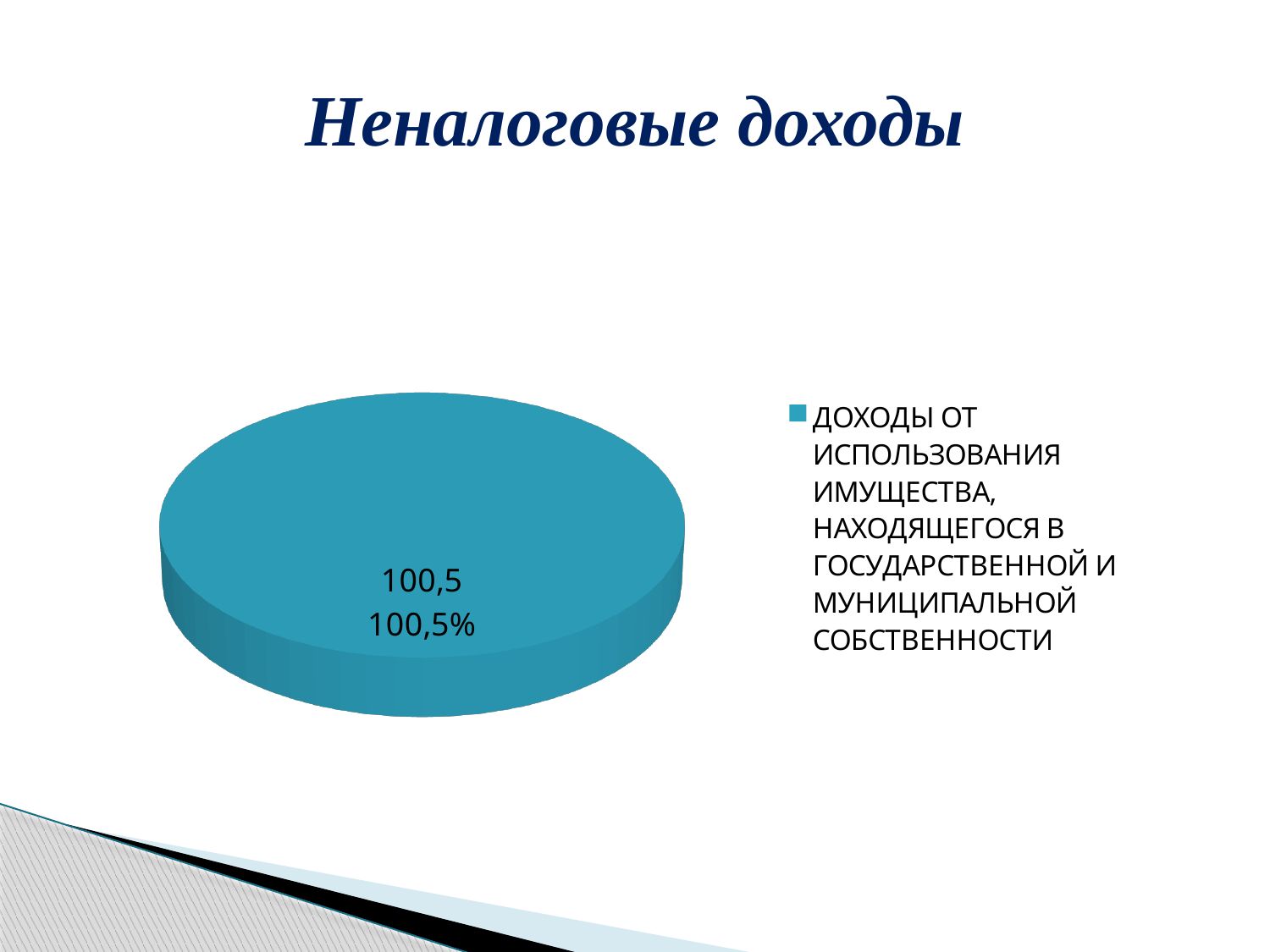
What kind of chart is shown on the slide? pie chart Is the value printed on the pie slice greater or less than 100? greater What percentage share is printed on the slice for ДОХОДЫ ОТ ИСПОЛЬЗОВАНИЯ ИМУЩЕСТВА, НАХОДЯЩЕГОСЯ В ГОСУДАРСТВЕННОЙ И МУНИЦИПАЛЬНОЙ СОБСТВЕННОСТИ? 100,5% How many slices does the pie chart have? 1 What is the legend entry of the pie chart? ДОХОДЫ ОТ ИСПОЛЬЗОВАНИЯ ИМУЩЕСТВА, НАХОДЯЩЕГОСЯ В ГОСУДАРСТВЕННОЙ И МУНИЦИПАЛЬНОЙ СОБСТВЕННОСТИ What is the title of the slide containing the pie chart? Неналоговые доходы What value is printed on the slice for ДОХОДЫ ОТ ИСПОЛЬЗОВАНИЯ ИМУЩЕСТВА, НАХОДЯЩЕГОСЯ В ГОСУДАРСТВЕННОЙ И МУНИЦИПАЛЬНОЙ СОБСТВЕННОСТИ? 100,5 How many entries does the legend of the pie chart list? 1